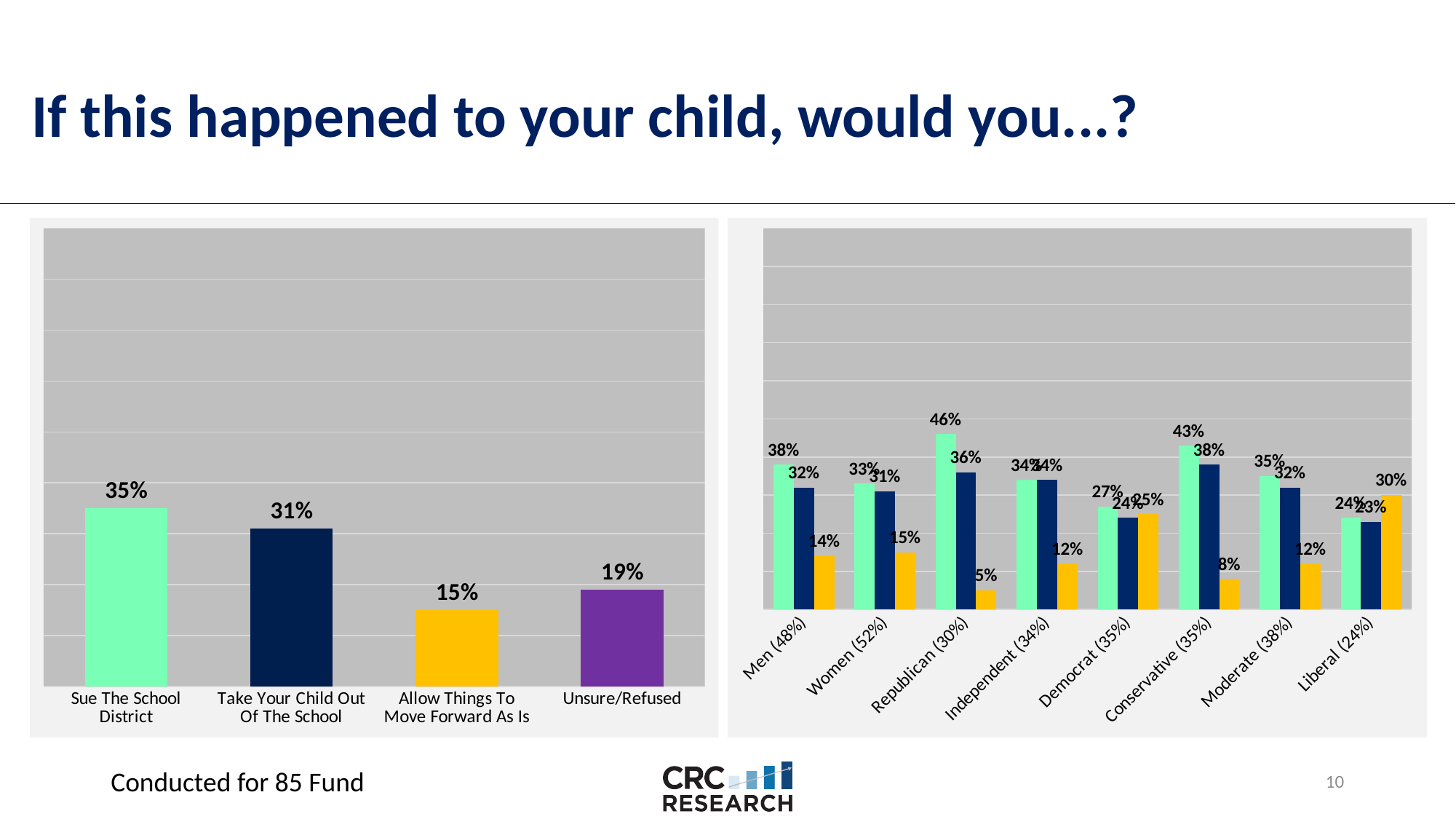
On the right chart, is the green bar for Conservative (35%) larger or smaller than the green bar for Democrat (35%)? larger On the right chart, which group has the lowest yellow bar? Republican (30%) What kind of chart is the left chart? bar chart On the right chart, how many groups are shown on the x axis? 8 On the left chart, which category has the highest value? Sue The School District On the left chart, what is the value for Sue The School District? 35% On the left chart, what is the difference between Sue The School District and Take Your Child Out Of The School? 4% On the right chart, what is the value of the yellow bar for Liberal (24%)? 30% On the right chart, what is the difference between the green bar and the navy bar for Men (48%)? 6% On the right chart, what is the value of the green bar for Republican (30%)? 46% On the left chart, which category has the lowest value? Allow Things To Move Forward As Is On the left chart, how many categories are shown? 4